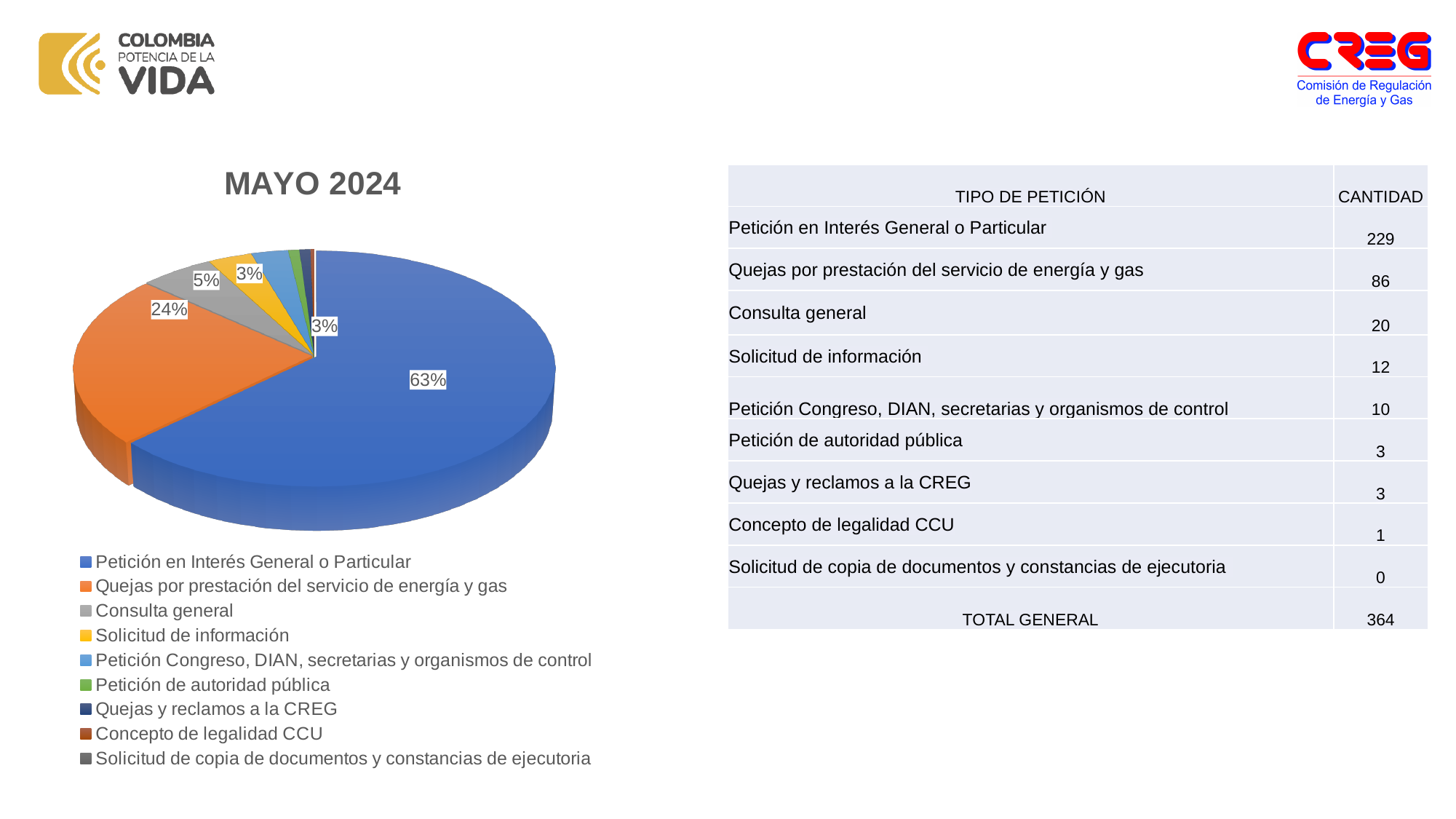
What colour is the largest slice of the pie chart? Blue What share of the pie does Consulta general represent? 5% By how many percentage points does the Quejas por prestación del servicio de energía y gas slice exceed the Consulta general slice? 19 percentage points How many categories are listed in the pie chart's legend? 9 What share of the pie does Petición en Interés General o Particular represent? 63% What share of the pie does Solicitud de información represent? 3% Which slice is larger: Quejas por prestación del servicio de energía y gas or Consulta general? Quejas por prestación del servicio de energía y gas Which category has the largest slice of the pie? Petición en Interés General o Particular By how many percentage points does the Petición en Interés General o Particular slice exceed the Quejas por prestación del servicio de energía y gas slice? 39 percentage points What is the title of the pie chart? MAYO 2024 What kind of chart is shown under the title MAYO 2024? Pie chart